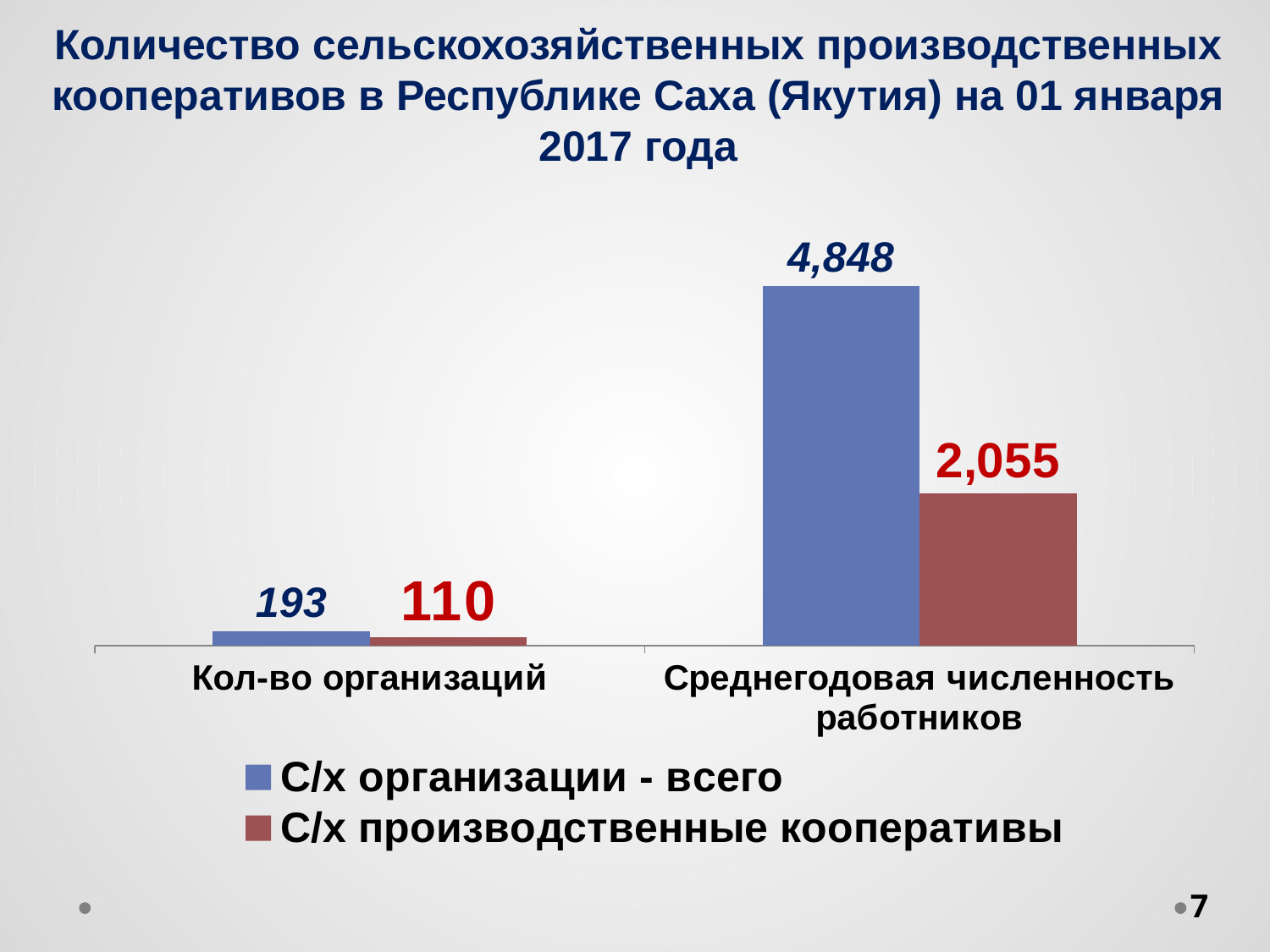
What is the difference between 'С/х организации - всего' and 'С/х производственные кооперативы' in the 'Кол-во организаций' category? 83 What is the value for 'С/х организации - всего' in the 'Кол-во организаций' category? 193 What is the difference between 'С/х организации - всего' and 'С/х производственные кооперативы' in the 'Среднегодовая численность работников' category? 2,793 What is the value for 'С/х организации - всего' in the 'Среднегодовая численность работников' category? 4,848 Which bar has the highest value on the chart? С/х организации - всего, Среднегодовая численность работников How many categories are shown on the x axis? 2 What is the value for 'С/х производственные кооперативы' in the 'Кол-во организаций' category? 110 Which is larger in the 'Кол-во организаций' category: 'С/х организации - всего' or 'С/х производственные кооперативы'? С/х организации - всего How many series does the legend list? 2 Which bar has the lowest value on the chart? С/х производственные кооперативы, Кол-во организаций What is the value for 'С/х производственные кооперативы' in the 'Среднегодовая численность работников' category? 2,055 What kind of chart is shown on the slide? Bar chart